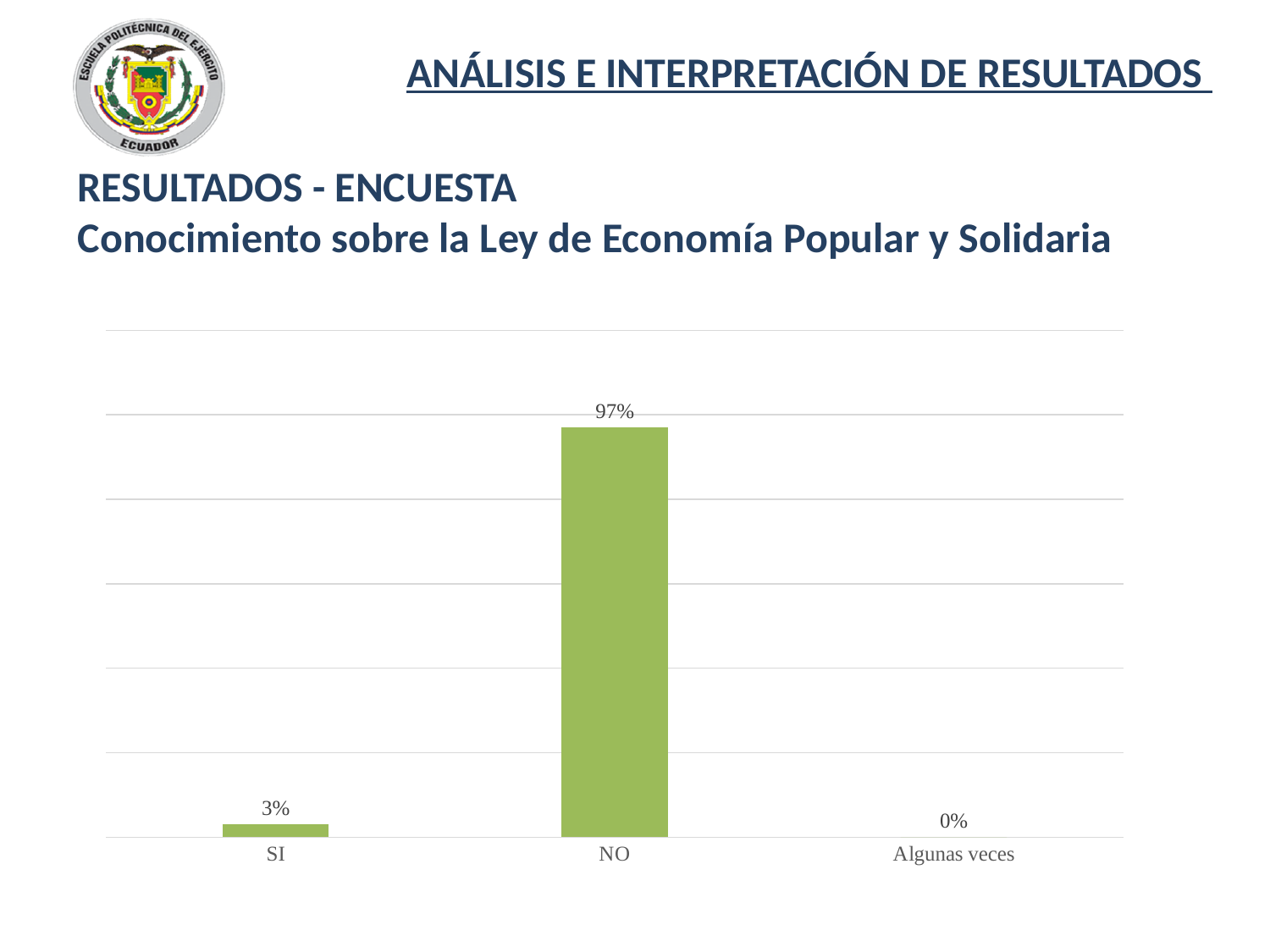
How many categories are shown on the x axis? 3 Which is larger, the value for SI or the value for NO? NO What kind of chart is shown on the slide? bar chart What is the total of the values for SI, NO and Algunas veces? 100% What is the value for SI? 3% What topic does the chart's heading say the survey results are about? Conocimiento sobre la Ley de Economía Popular y Solidaria Which category has the lowest value? Algunas veces What colour are the bars in the chart? green Which category has the highest value? NO What is the value for NO? 97% What is the value for Algunas veces? 0% What is the difference between the values for NO and SI? 94%